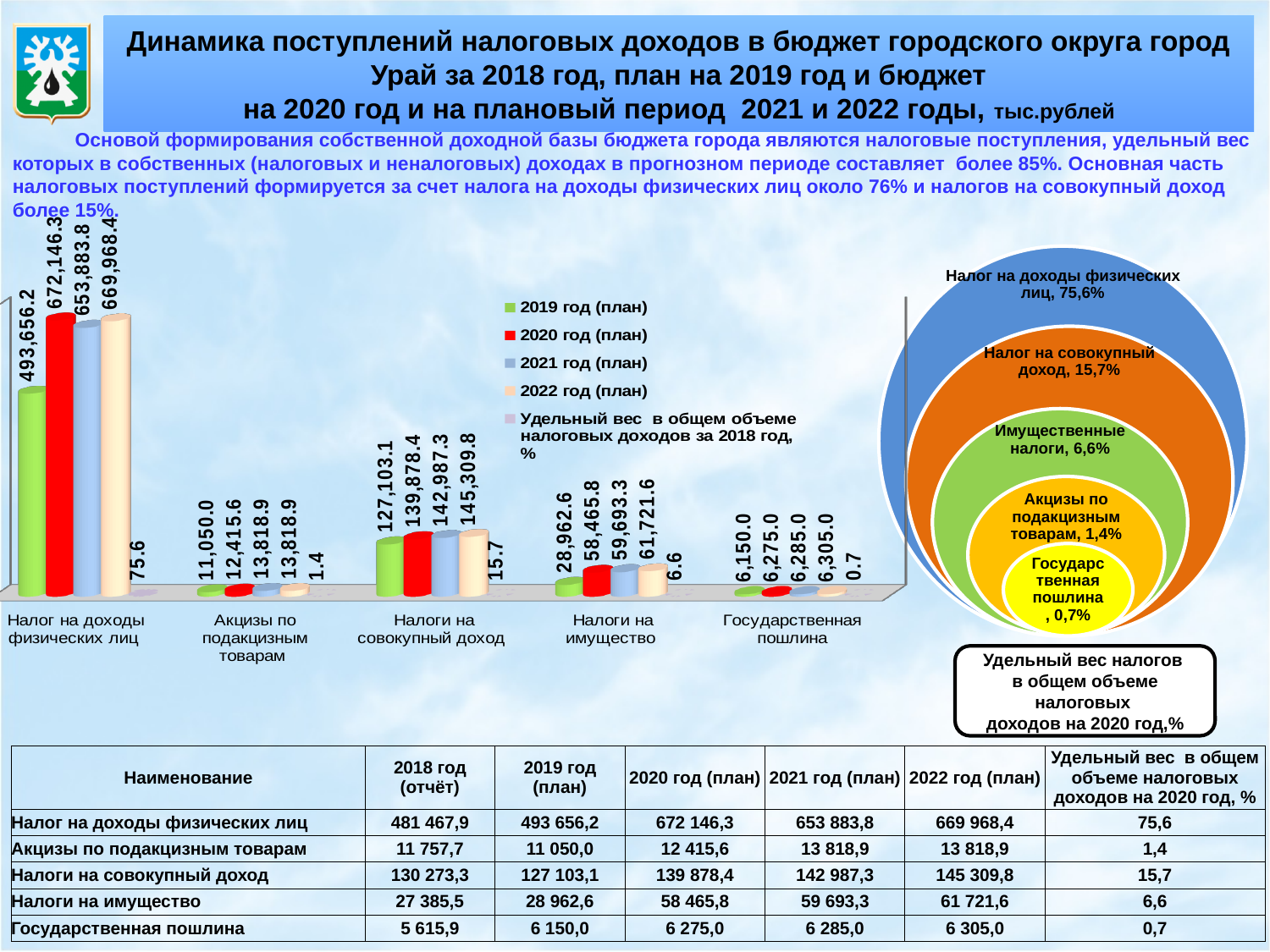
In the bar chart, which category has the highest value in the 2021 год (план) series? Налог на доходы физических лиц In the bar chart, what is the value for Налог на доходы физических лиц in the 2020 год (план) series? 672,146.3 In the bar chart, what is the difference between the 2021 год (план) and 2020 год (план) values for Налоги на имущество? 1,227.5 In the bar chart, what is the difference between the 2022 год (план) and 2019 год (план) values for Налоги на совокупный доход? 18,206.7 In the bar chart, which category has the lowest value in the 2022 год (план) series? Государственная пошлина What kind of chart is the chart on the left of the slide? Bar chart In the bar chart, what is the value for Налоги на имущество in the 2022 год (план) series? 61,721.6 How many categories are shown on the x axis of the bar chart? 5 In the bar chart, do the values for Налоги на имущество rise or fall from 2019 год (план) to 2022 год (план)? Rise In the bar chart, for Налог на доходы физических лиц, which is larger: the 2020 год (план) value or the 2021 год (план) value? 2020 год (план) In the bar chart, what is the value for Государственная пошлина in the 2019 год (план) series? 6,150.0 How many series does the legend of the bar chart list? 5